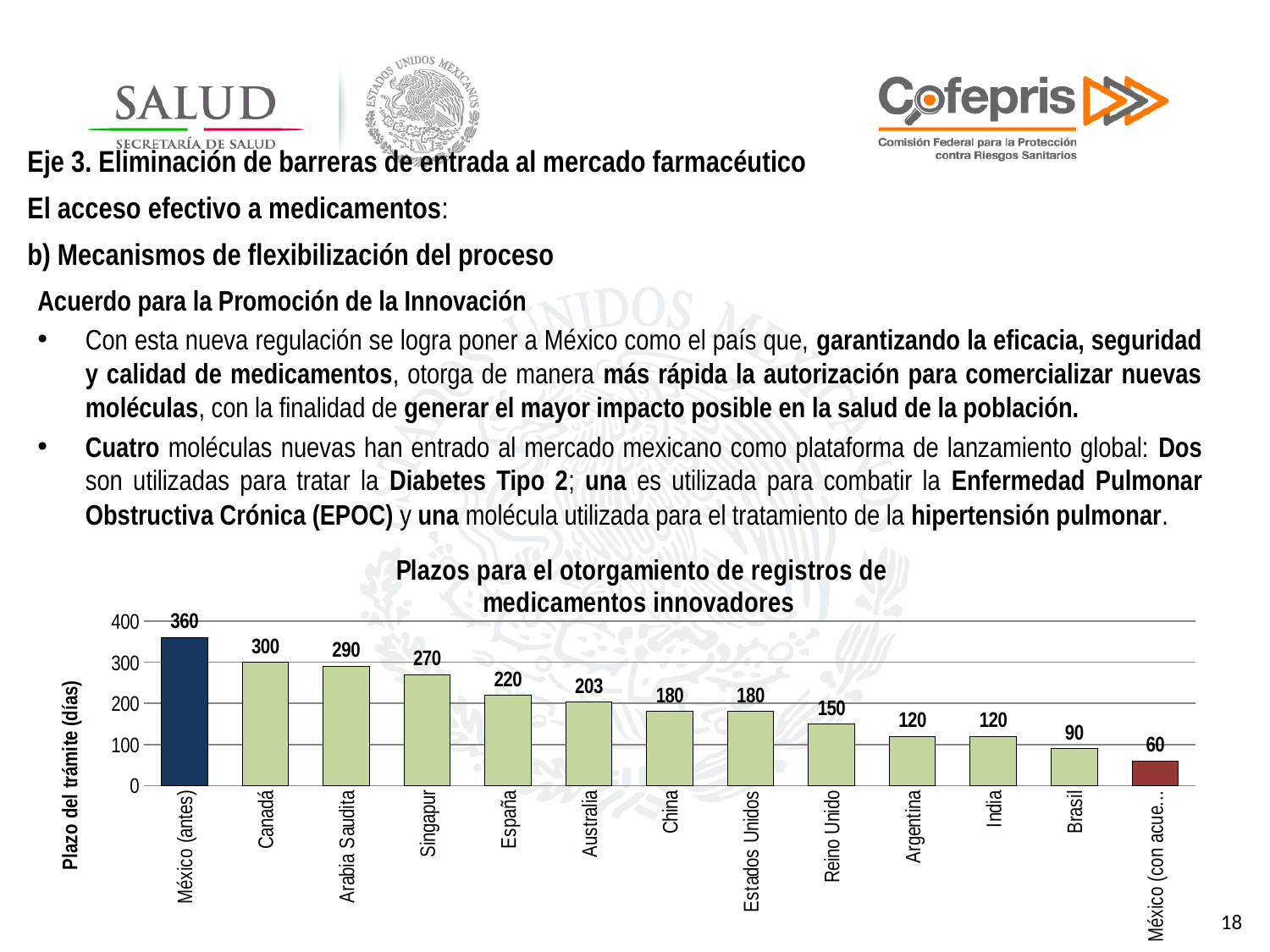
What is the difference between the values for España and Brasil? 130 What is the difference between the values for México (antes) and Canadá? 60 What is the value for Reino Unido? 150 How many categories are shown in the chart? 13 Which category has the lowest value? México (con acue...) What is the label of the vertical axis? Plazo del trámite (días) Do the values generally rise or fall from left to right along the x axis? fall What is the value for Australia? 203 Which is larger, the value for Singapur or the value for Estados Unidos? Singapur What type of chart is shown on the slide? bar chart What is the value for Canadá? 300 Which category has the highest value? México (antes)